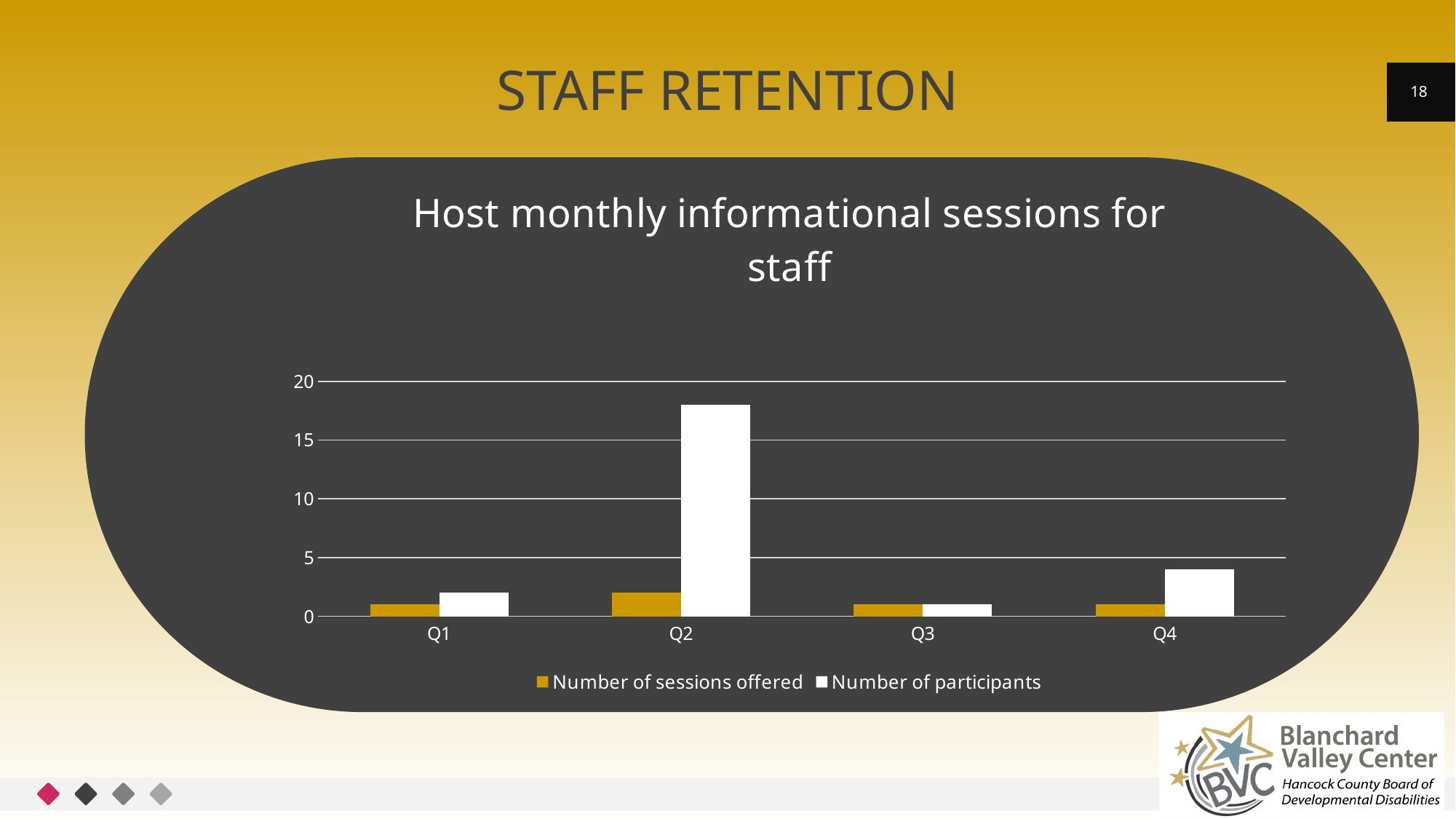
Which is larger: the number of participants in Q2 or in Q4? Q2 What kind of chart is shown on the slide? bar chart How many series does the legend list? 2 Which is larger: the number of participants in Q4 or in Q3? Q4 Is the number of participants in Q4 greater or less than 5? less Which quarter has the highest number of sessions offered? Q2 Which series is shown in white bars? Number of participants What is the title of the chart? Host monthly informational sessions for staff Which quarter has the highest number of participants? Q2 How many quarters are shown on the x axis? 4 Is the number of participants in Q2 greater or less than 15? greater Is the number of participants in Q1 greater or less than 5? less